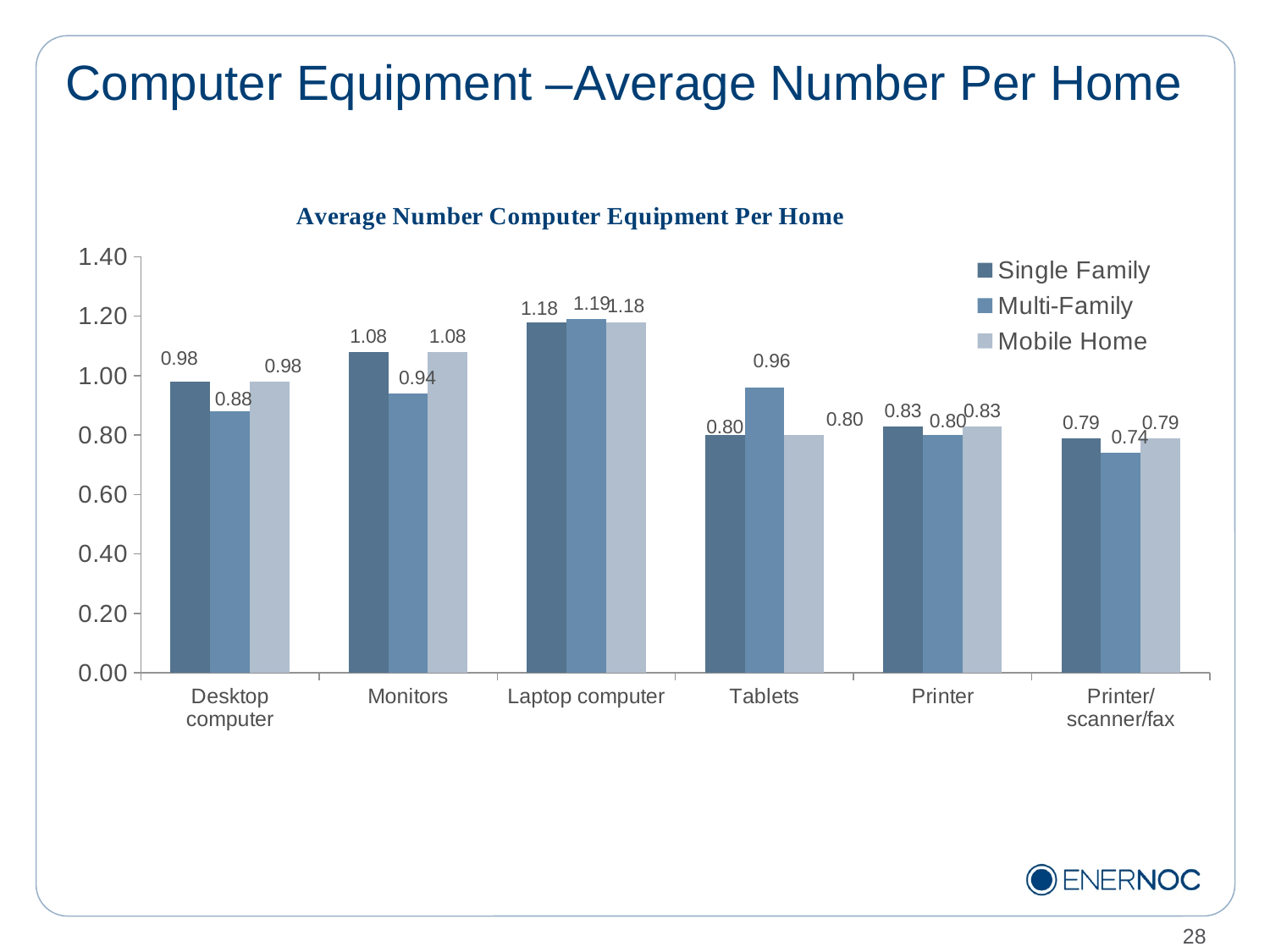
Which category has the lowest Multi-Family value? Printer/ scanner/fax Which is larger for Monitors: the Single Family value or the Multi-Family value? Single Family What is the difference between the Multi-Family and Mobile Home values for Tablets? 0.16 Is the Single Family value for Printer greater or less than 1.00? less Which category has the highest Single Family value? Laptop computer What kind of chart is shown on the slide? bar chart What is the value for Mobile Home for Monitors? 1.08 What is the value for Multi-Family for Tablets? 0.96 What is the value for Multi-Family for Printer/ scanner/fax? 0.74 What is the value for Multi-Family for Desktop computer? 0.88 How many series does the legend list? 3 How many categories are shown on the x axis? 6